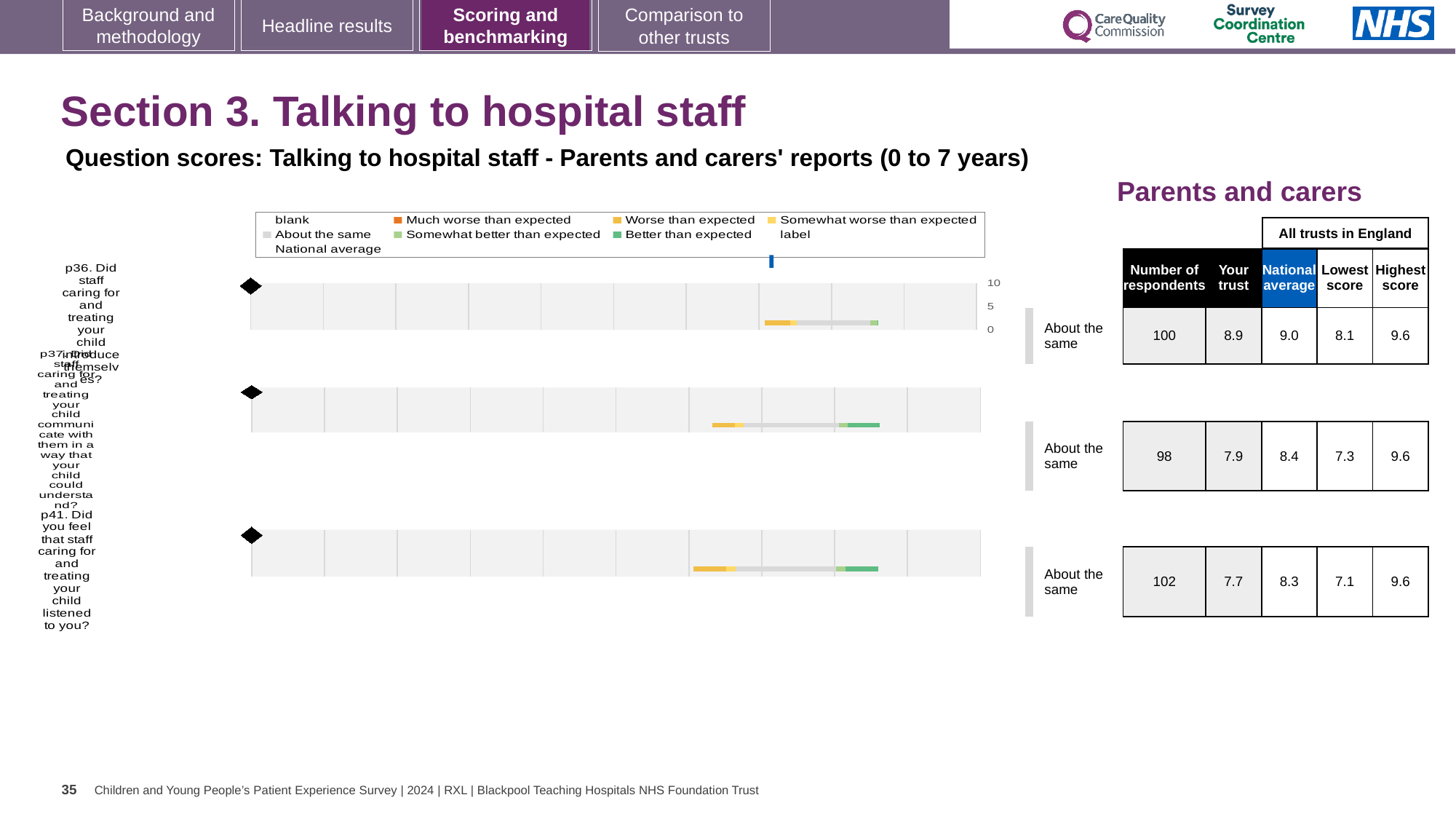
What is the Highest score across all trusts in England for p41? 9.6 How many questions (p36, p37, p41) are plotted as separate bars on the slide? 3 For p37, which is larger: the 'Your trust' score or the National average? National average What is the 'Your trust' score for p36 (Did staff caring for and treating your child introduce themselves?)? 8.9 What is the difference between the National average and the 'Your trust' score for p36? 0.1 What kind of chart is used to show the question scores on this slide? bar chart Which question has the lowest 'Your trust' score? p41 What is the highest value shown on the chart's numeric axis? 10 What benchmark category is shown next to the bar for p36? About the same What is the National average score for p37 (Did staff communicate with your child in a way they could understand?)? 8.4 Which question has the highest 'Your trust' score? p36 How many respondents answered p41 (Did you feel that staff caring for and treating your child listened to you?)? 102